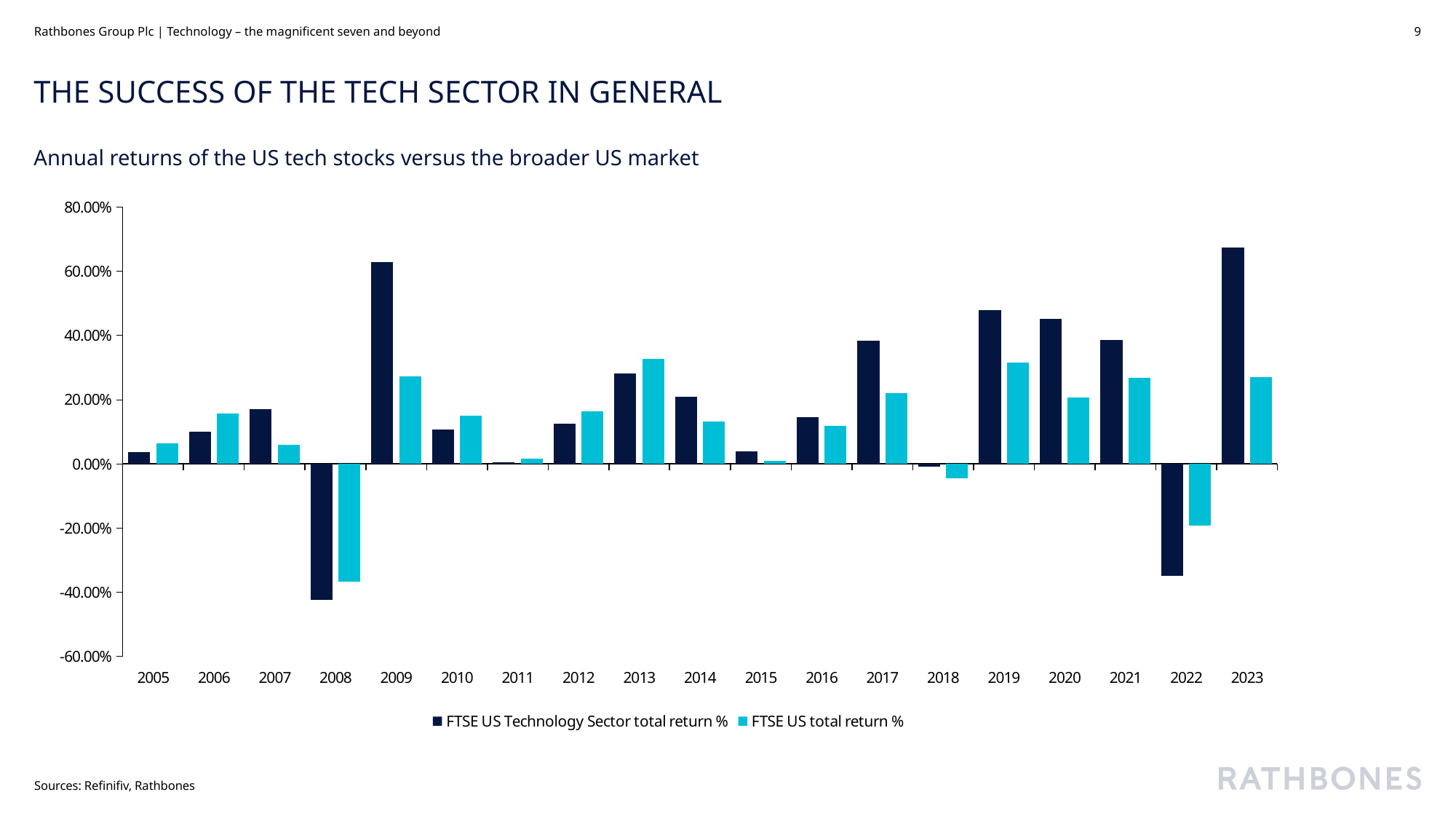
Is the FTSE US total return % for 2019 greater or less than 20.00%? greater Is the FTSE US Technology Sector total return % for 2009 greater or less than 40.00%? greater In which year is the FTSE US total return % lowest? 2008 How many series does the legend list? 2 How many years are shown on the x axis of the chart? 19 Which series is shown in dark navy bars? FTSE US Technology Sector total return % What kind of chart is shown on the slide? Bar chart Is the FTSE US Technology Sector total return % for 2022 greater or less than -20.00%? less In which year is the FTSE US Technology Sector total return % highest? 2023 In 2017, which is larger: the FTSE US Technology Sector total return % or the FTSE US total return %? FTSE US Technology Sector total return % In which year is the FTSE US Technology Sector total return % lowest? 2008 In 2013, which is larger: the FTSE US Technology Sector total return % or the FTSE US total return %? FTSE US total return %